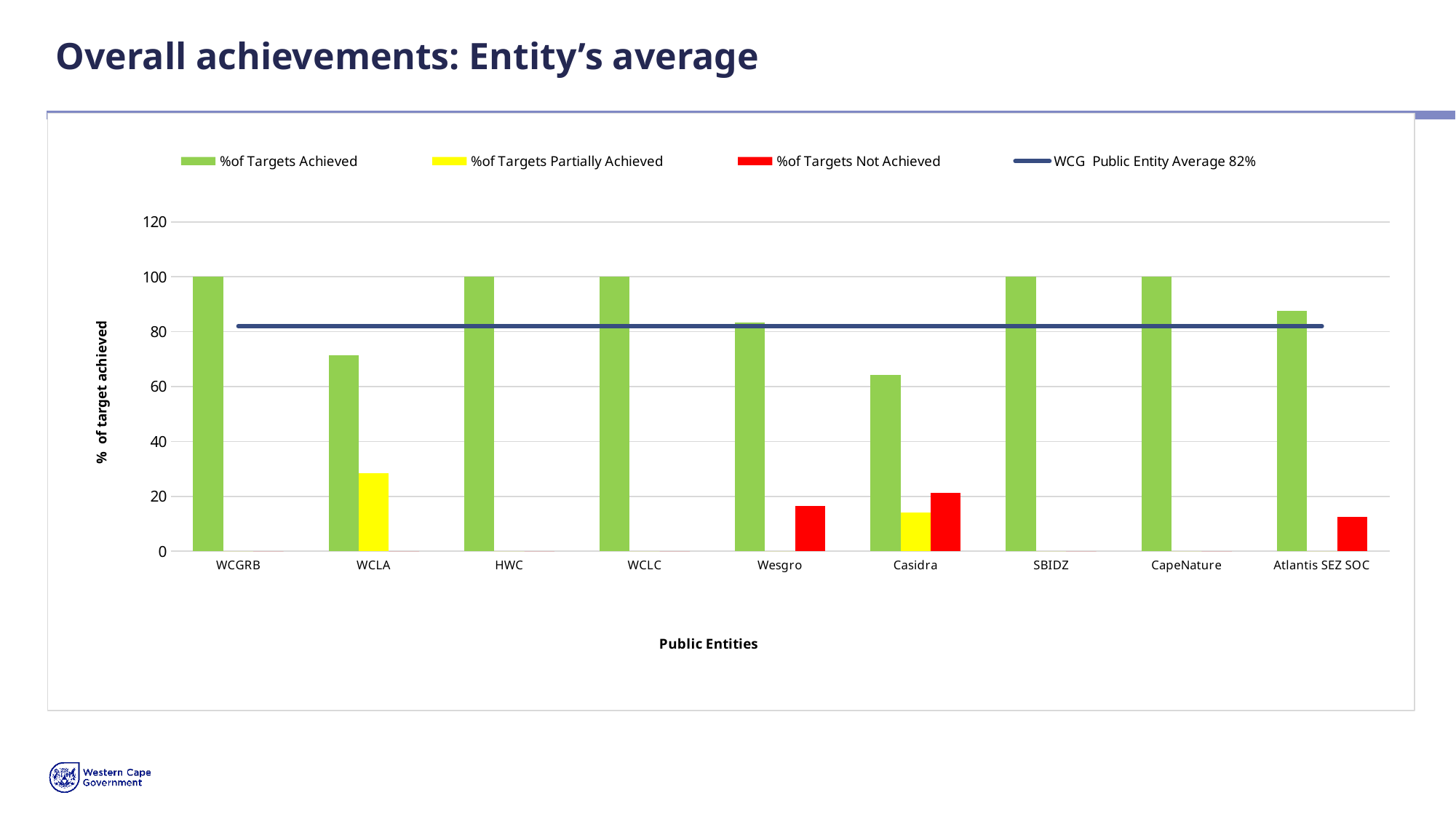
Is the % of Targets Not Achieved for Wesgro greater or less than 20? less How many public entities are shown on the x axis? 9 What is the WCG Public Entity Average shown in the legend? 82% Which public entity has the lowest % of Targets Achieved? Casidra What is the % of Targets Achieved for WCGRB? 100 Is the % of Targets Achieved for Atlantis SEZ SOC greater or less than 80? greater Is the % of Targets Partially Achieved for WCLA greater or less than 20? greater What is the % of Targets Achieved for SBIDZ? 100 What kind of chart is shown on the slide? bar chart How many entries does the legend list? 4 Which has the higher % of Targets Achieved, WCLA or Casidra? WCLA